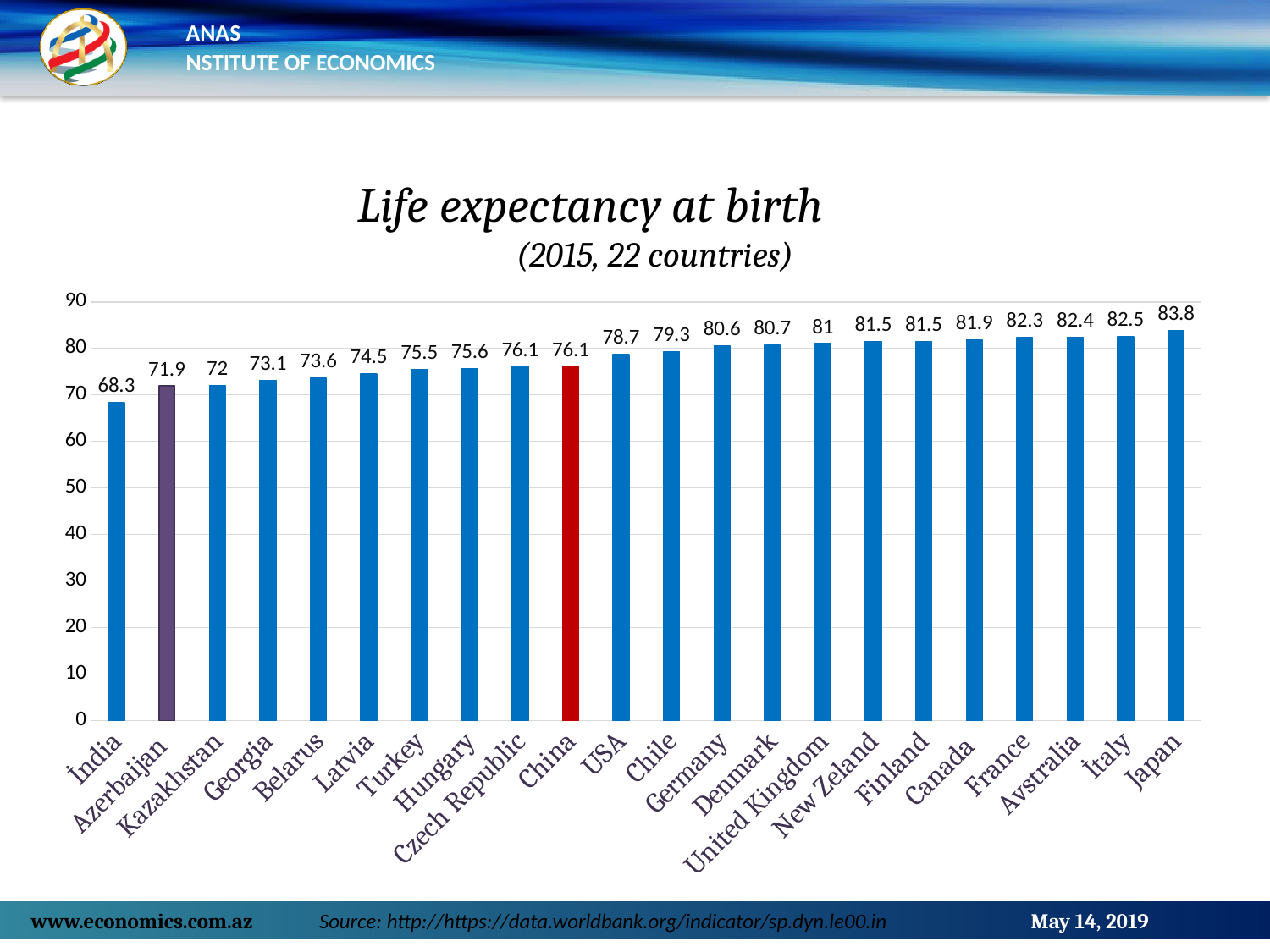
What is the life expectancy at birth shown for China? 76.1 What is the life expectancy at birth shown for Japan? 83.8 Which country's bar is coloured red on the chart? China What is the life expectancy at birth shown for Azerbaijan? 71.9 Is the value for USA greater or less than 80? less What is the difference between the life expectancy values for Azerbaijan and Kazakhstan? 0.1 Which has a higher life expectancy at birth, Germany or Chile? Germany What is the difference between the life expectancy values for Japan and India? 15.5 What kind of chart is shown on the slide? Bar chart How many countries are shown on the chart? 22 Which country has the highest life expectancy at birth on the chart? Japan Which country has the lowest life expectancy at birth on the chart? India